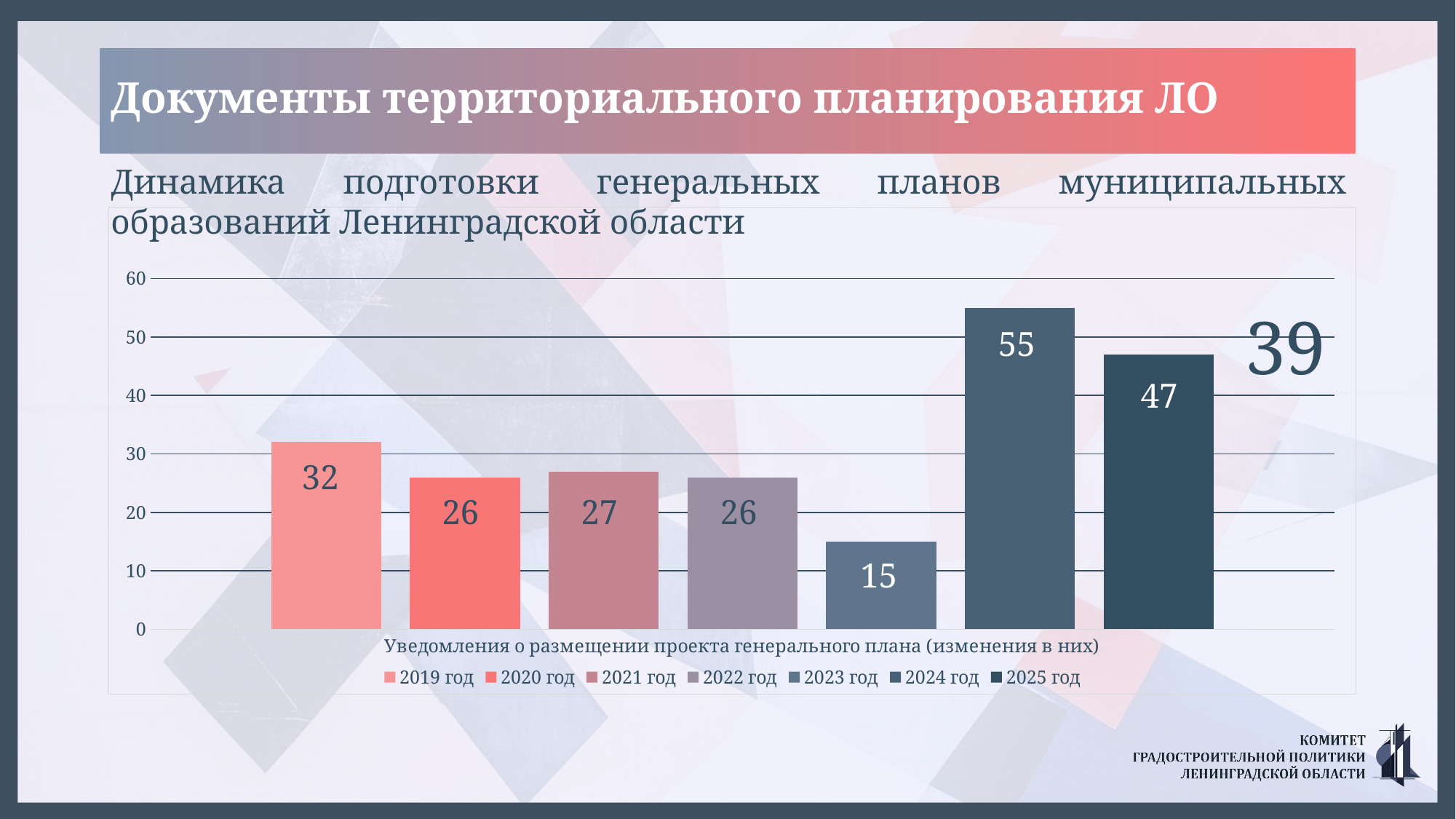
What is the category label shown on the x axis of the chart? Уведомления о размещении проекта генерального плана (изменения в них) What kind of chart is shown on the slide? bar chart What is the value for 2023 год? 15 What is the value for 2025 год? 47 Is the value for 2024 год greater or less than 50? greater Which year has the lowest value? 2023 год How many series does the legend list? 7 Which is larger, the value for 2019 год or the value for 2021 год? 2019 год Which year has the highest value? 2024 год What is the value for 2019 год? 32 What is the difference between the values for 2024 год and 2025 год? 8 What is the difference between the values for 2019 год and 2023 год? 17